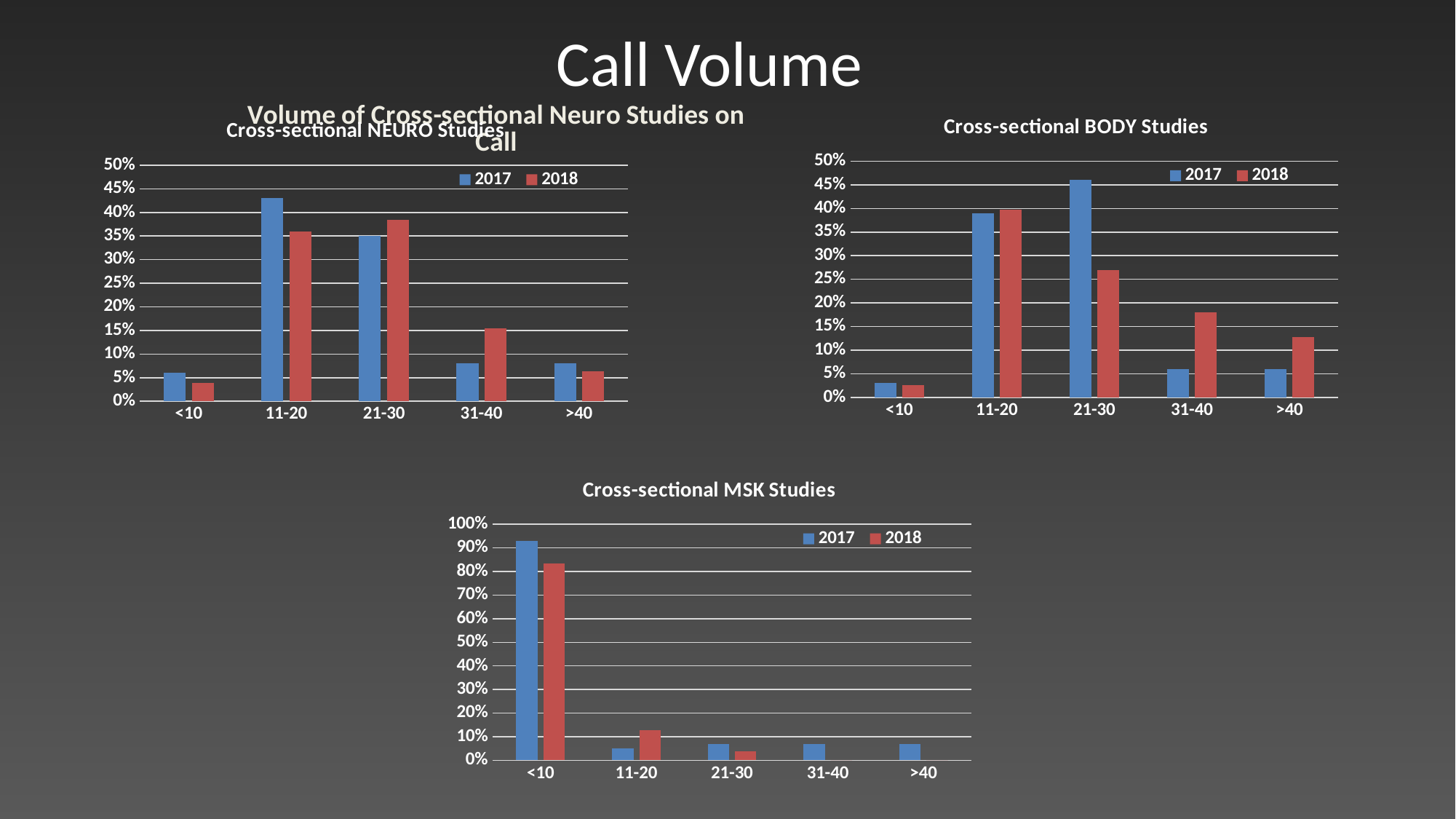
In the Cross-sectional BODY Studies chart, is the 2018 value for 31-40 greater or less than 15%? greater In the Cross-sectional NEURO Studies chart, is the 2017 value for 11-20 greater or less than 40%? greater In the Cross-sectional BODY Studies chart, which category has the highest value for 2017? 21-30 In the Cross-sectional BODY Studies chart, for the 21-30 category, which series is larger, 2017 or 2018? 2017 How many series does the legend of the Cross-sectional BODY Studies chart list? 2 In the Cross-sectional MSK Studies chart, for the 11-20 category, which series is larger, 2017 or 2018? 2018 In the Cross-sectional NEURO Studies chart, which category has the lowest value for 2018? <10 What kind of chart is the Cross-sectional MSK Studies chart? bar chart In the Cross-sectional NEURO Studies chart, which category has the highest value for 2017? 11-20 In the Cross-sectional MSK Studies chart, is the 2017 value for <10 greater or less than 80%? greater How many categories are shown on the x axis of the Cross-sectional MSK Studies chart? 5